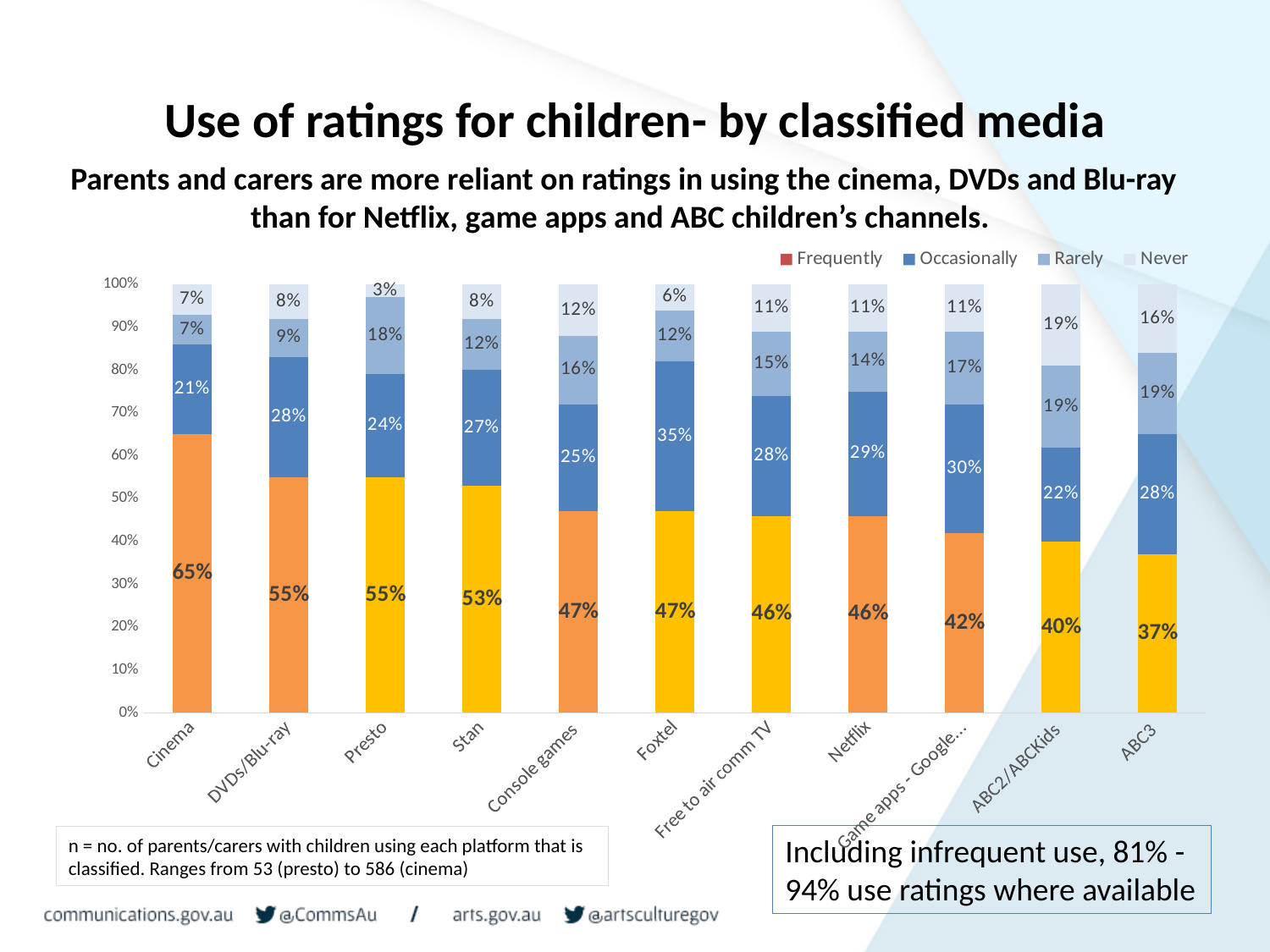
How many media categories are shown on the x axis? 11 What is the Rarely value for ABC2/ABCKids? 19% What is the difference between the Frequently values for Cinema and ABC3? 28 percentage points How many series does the legend list? 4 What is the Occasionally value for Foxtel? 35% Which media has the highest Frequently value? Cinema What is the Never value for Presto? 3% Do the Frequently values rise or fall moving from Cinema on the left to ABC3 on the right? Fall Which has a larger Occasionally value, Foxtel or Netflix? Foxtel What kind of chart is shown on the slide? Stacked bar chart What percentage of parents/carers use ratings Frequently for Cinema? 65% Which media has the lowest Frequently value? ABC3